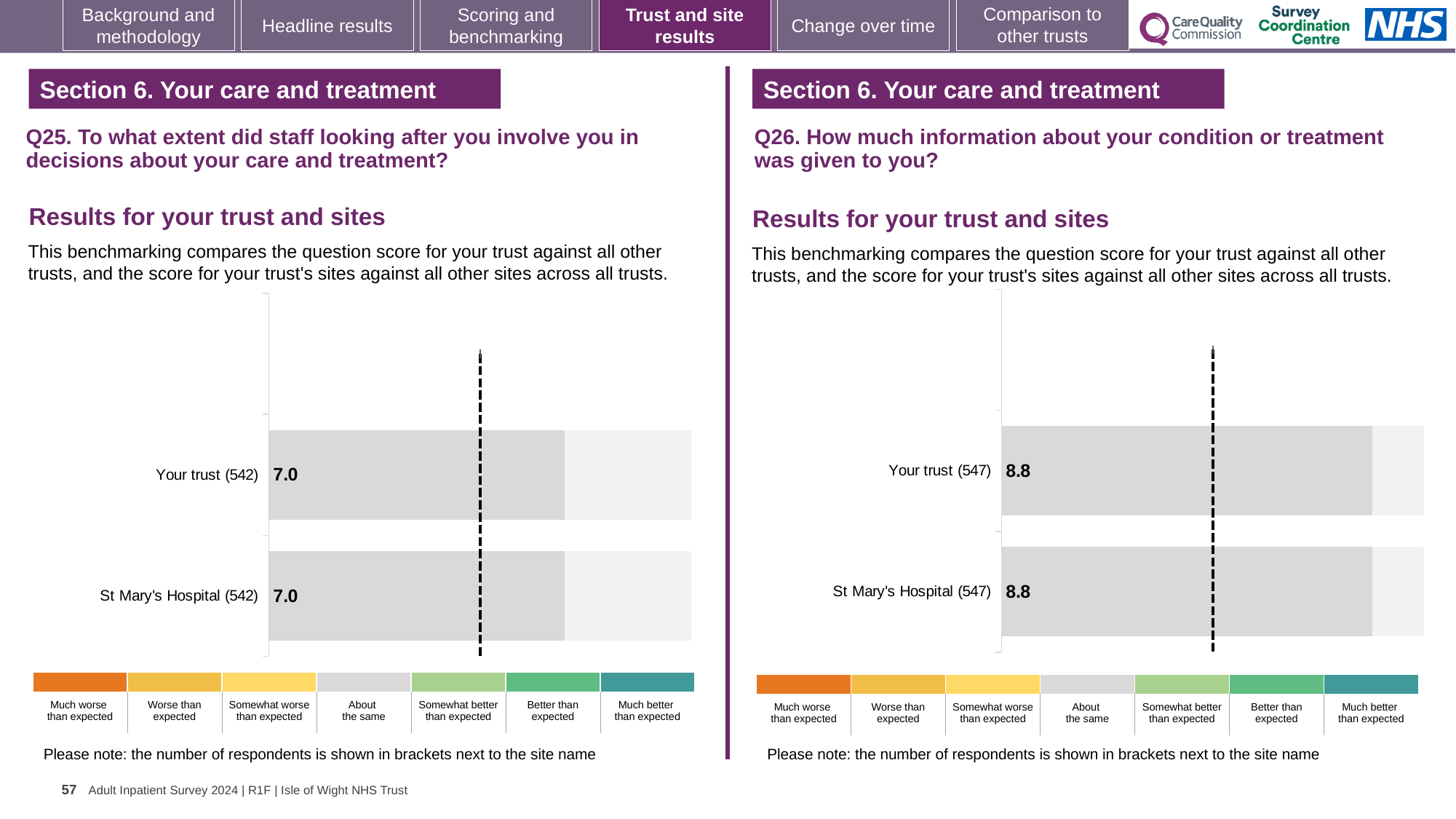
What kind of chart is the Q26 chart on the right? Bar chart In the Q26 chart on the right, what is the score for St Mary's Hospital? 8.8 In the Q25 chart on the left, which category does the colour key label with the dark teal colour at the far right? Much better than expected In the Q25 chart on the left, how many respondents are shown in brackets for Your trust? 542 In the Q26 chart on the right, what is the score for Your trust? 8.8 How many bars are plotted in the Q25 chart on the left? 2 In the Q26 chart on the right, how many respondents are shown in brackets for St Mary's Hospital? 547 In the Q26 chart on the right, what is the difference between the score for Your trust and the score for St Mary's Hospital? 0.0 In the Q25 chart on the left, what is the score for St Mary's Hospital? 7.0 In the Q25 chart on the left, what is the score for Your trust? 7.0 How many bars are plotted in the Q26 chart on the right? 2 In the Q25 chart on the left, what is the difference between the score for Your trust and the score for St Mary's Hospital? 0.0